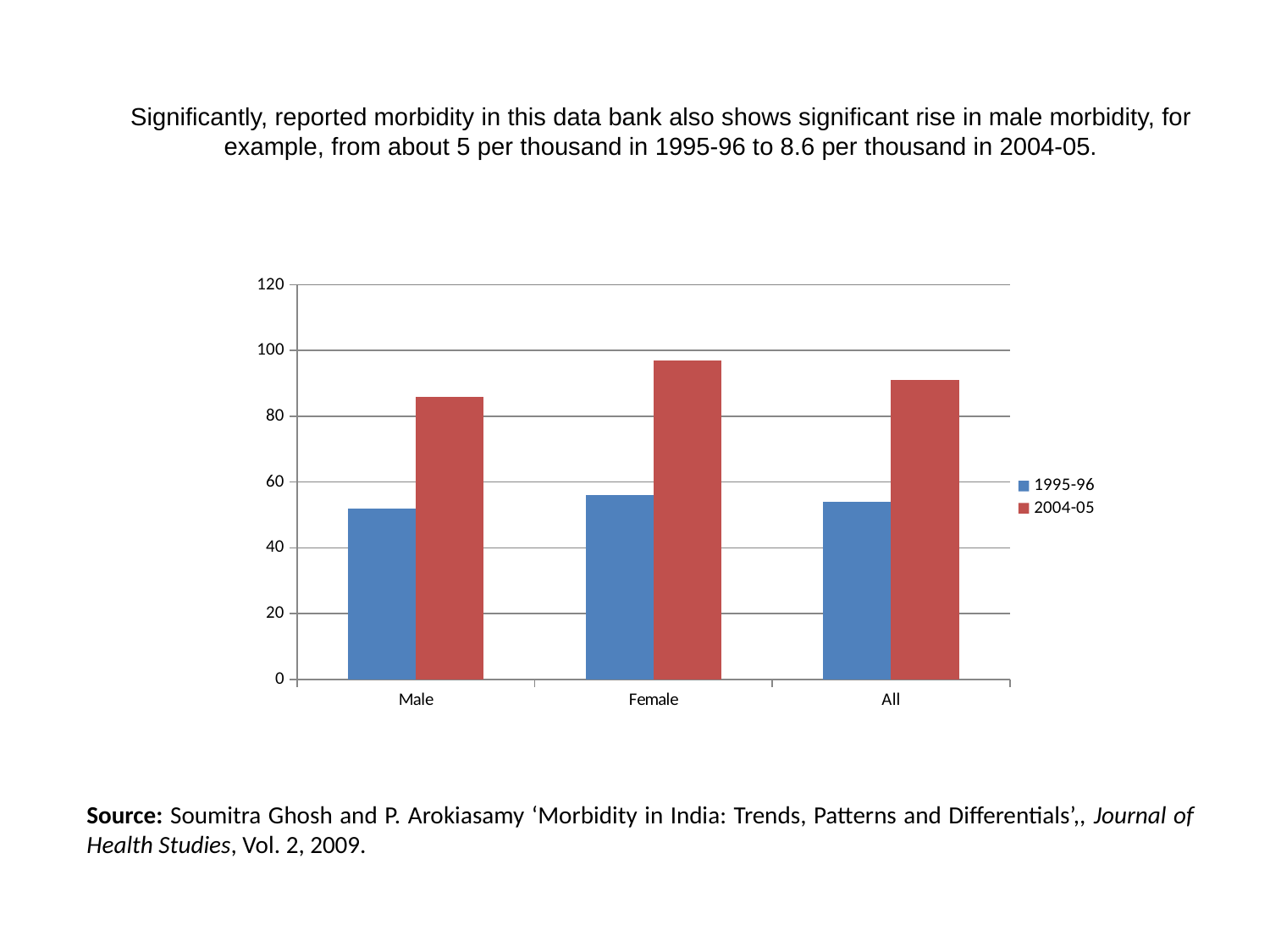
Is the 2004-05 value for Male greater or less than 80? greater Is the 1995-96 value for Male greater or less than 60? less Which category has the lowest value for the 2004-05 series? Male Which is larger: the 2004-05 value for Female or the 2004-05 value for Male? Female Which category has the highest value for the 2004-05 series? Female Is the 2004-05 value for Female greater or less than 100? less How many categories are shown on the x axis of the chart? 3 How many series does the chart's legend list? 2 Which series does the legend list first? 1995-96 For the Male category, which series has the larger value, 1995-96 or 2004-05? 2004-05 What kind of chart is shown on the slide? bar chart